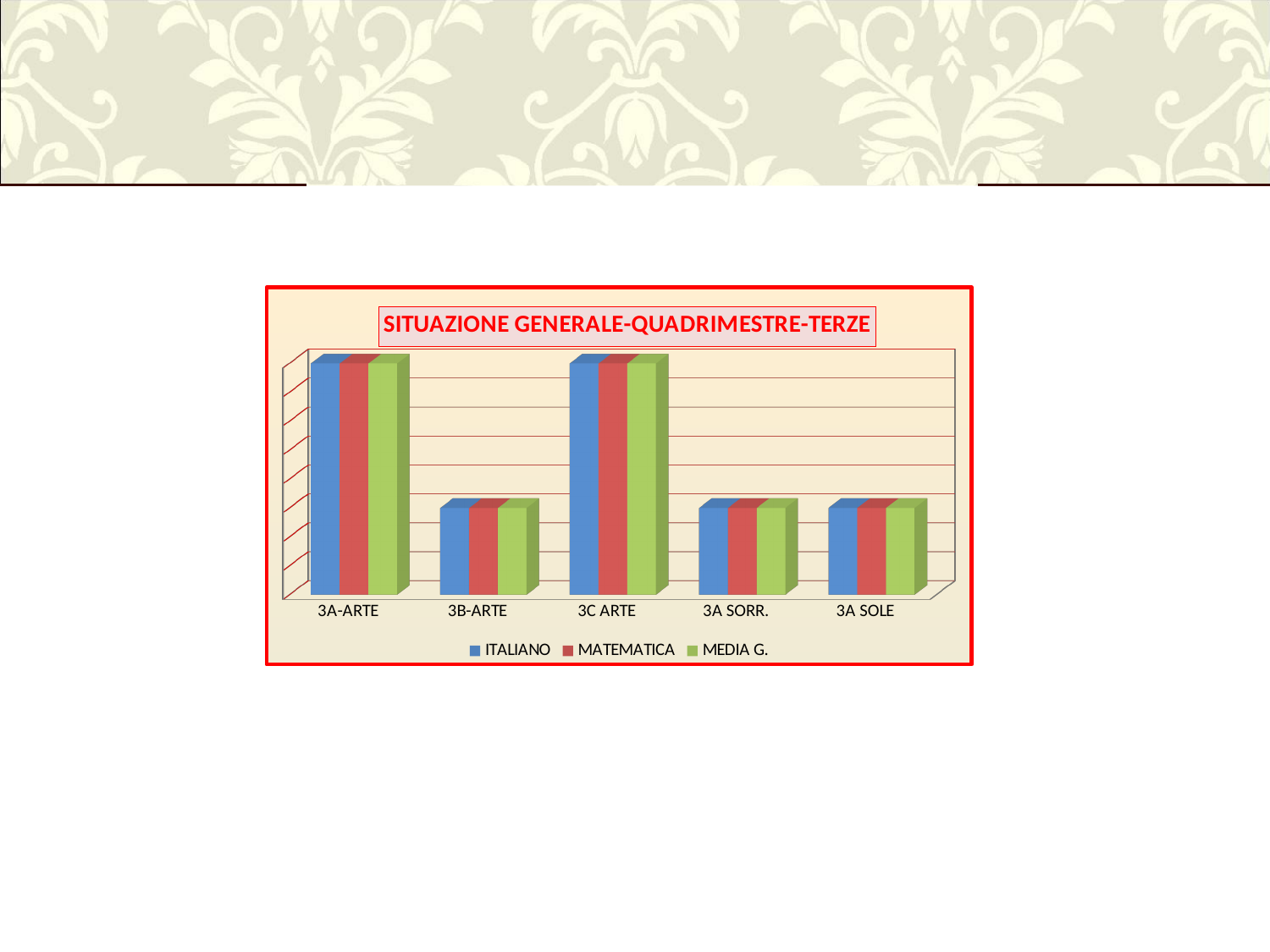
How many categories are shown on the x axis? 5 Which is larger, the MEDIA G. value for 3A SORR. or the MEDIA G. value for 3A-ARTE? 3A-ARTE What kind of chart is shown on the slide? Bar chart Which is larger, the ITALIANO value for 3A-ARTE or the ITALIANO value for 3B-ARTE? 3A-ARTE Which is larger, the ITALIANO value for 3C ARTE or the ITALIANO value for 3A SORR.? 3C ARTE Which series is shown in blue in the legend? ITALIANO What is the title of the chart? SITUAZIONE GENERALE-QUADRIMESTRE-TERZE How many series does the legend list? 3